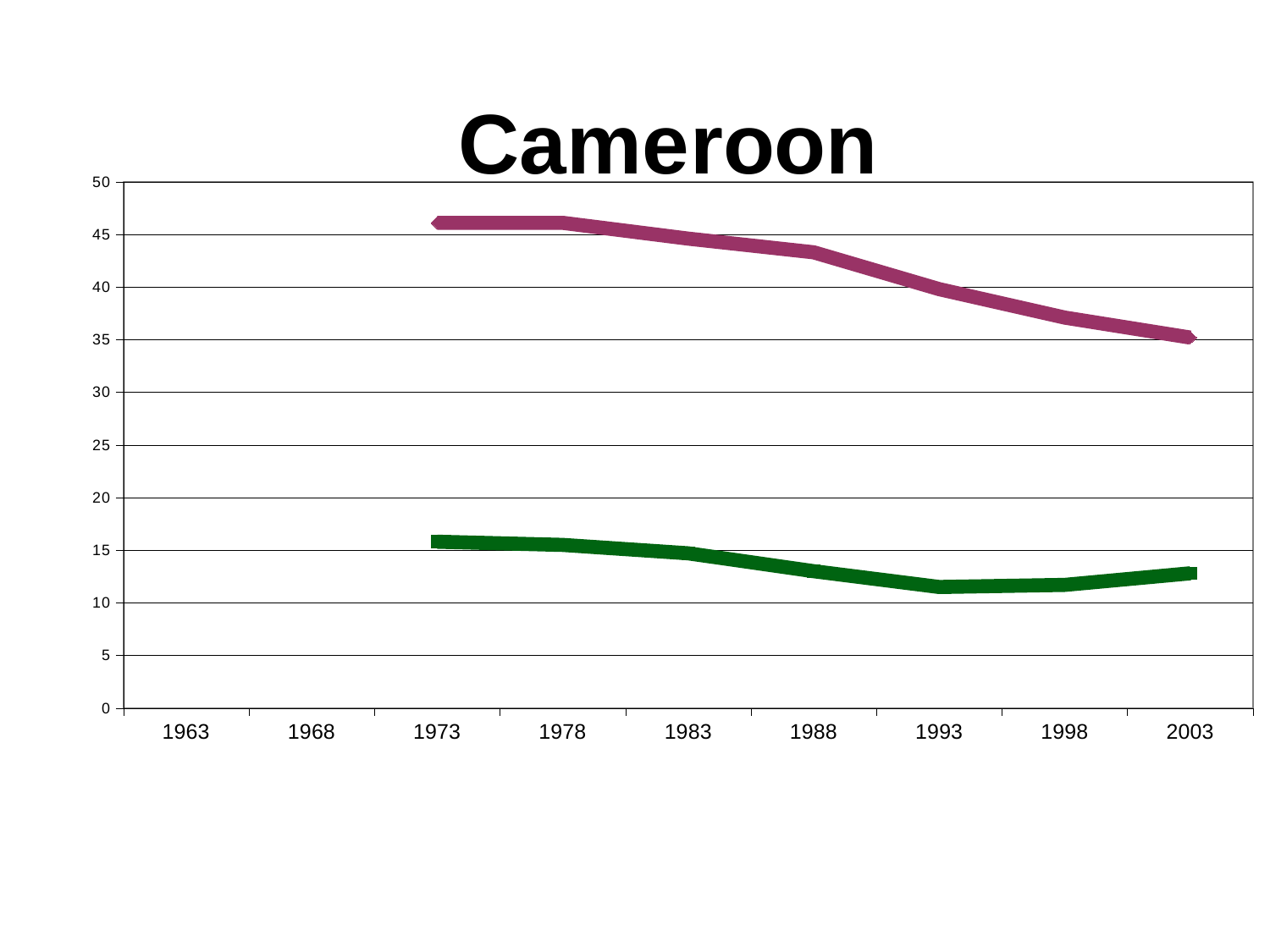
Does the green line rise or fall from 1993 to 2003? rise Is the value of the purple line in 1973 greater or less than 45? greater Is the value of the green line in 1993 greater or less than 15? less What is the title of the chart? Cameroon How many lines are plotted on the chart? 2 Is the value of the green line in 1973 greater or less than 15? greater In which year does the purple line reach its lowest value? 2003 Does the purple line rise or fall from 1973 to 2003? fall What kind of chart is shown on the slide? line chart Which line has the higher value in 2003, the purple line or the green line? the purple line